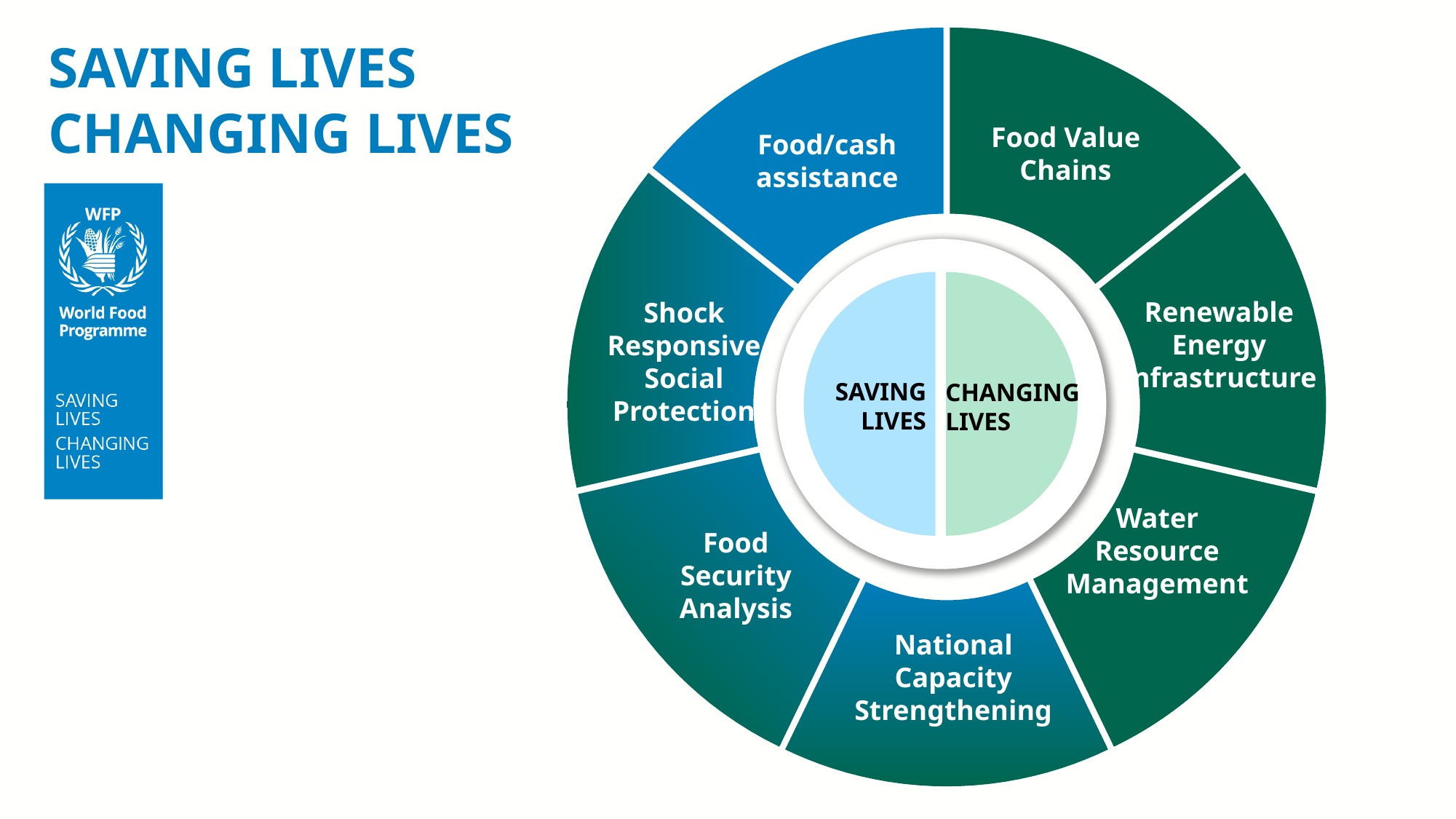
What label appears in the right half of the inner circle? CHANGING LIVES Which outer segment is located at the bottom of the ring, between 'Food Security Analysis' and 'Water Resource Management'? National Capacity Strengthening What is the title shown at the top left of the slide? SAVING LIVES CHANGING LIVES How many sections is the inner circle of the diagram divided into? 2 What kind of chart is the large graphic on the right of the slide? Donut (ring) chart How many labelled segments make up the outer ring of the diagram? 7 Which outer segment sits directly above the 'Shock Responsive Social Protection' segment? Food/cash assistance Which outer segment is at the top right of the ring, next to 'Food/cash assistance'? Food Value Chains What label appears in the left half of the inner circle? SAVING LIVES